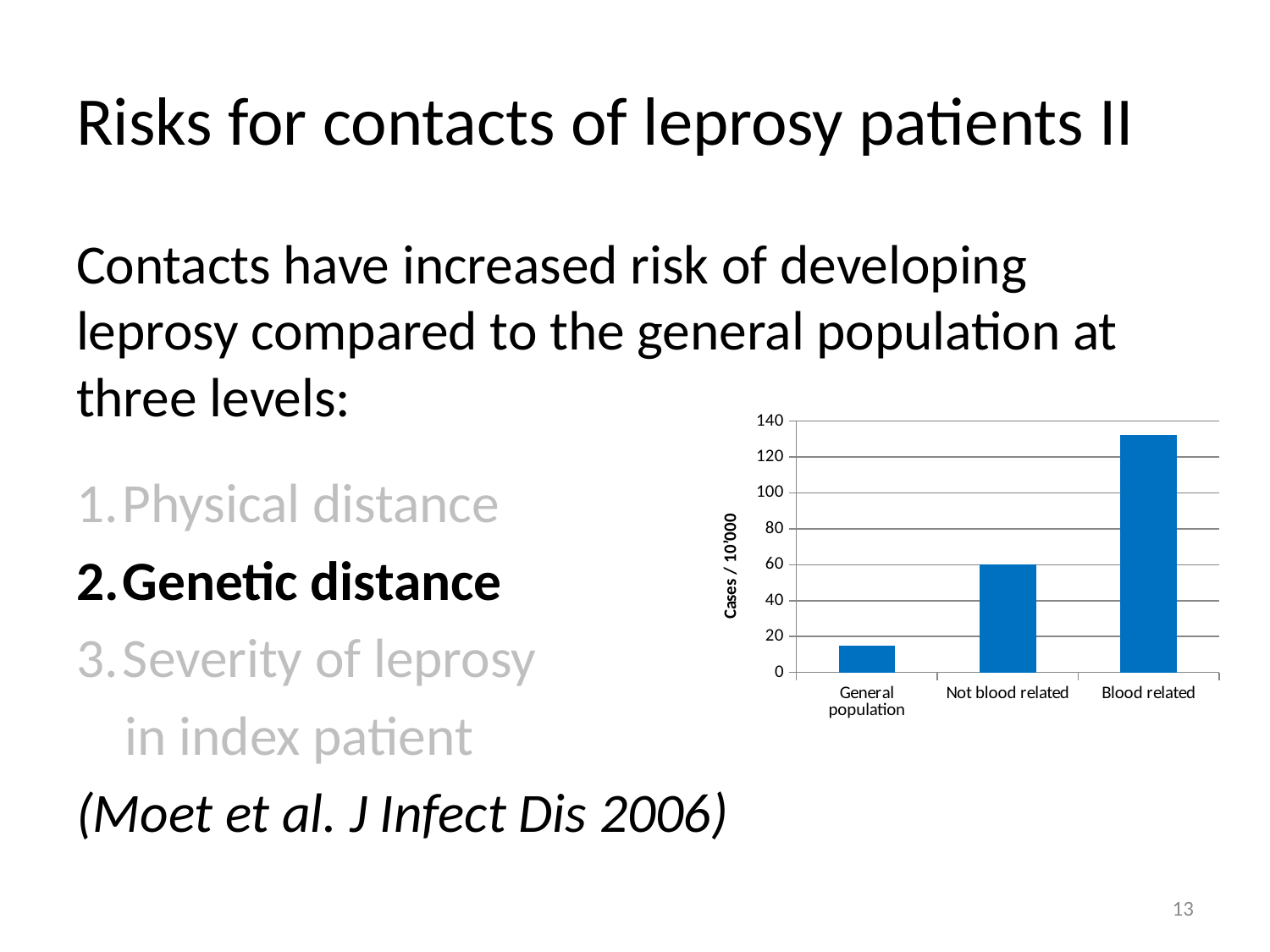
What is the label on the y axis of the chart? Cases / 10'000 Which category has the highest value in the chart? Blood related What kind of chart is shown on the slide? bar chart Which category has the lowest value in the chart? General population Is the value for Not blood related greater or less than 40? greater Do the values rise or fall from General population to Blood related along the x axis? rise How many categories are shown on the x axis of the chart? 3 Is the value for Blood related greater or less than 120? greater Which is larger, the value for Blood related or the value for Not blood related? Blood related What is the highest value shown on the y axis of the chart? 140 What is the value for Not blood related in the chart? 60 Is the value for General population greater or less than 20? less